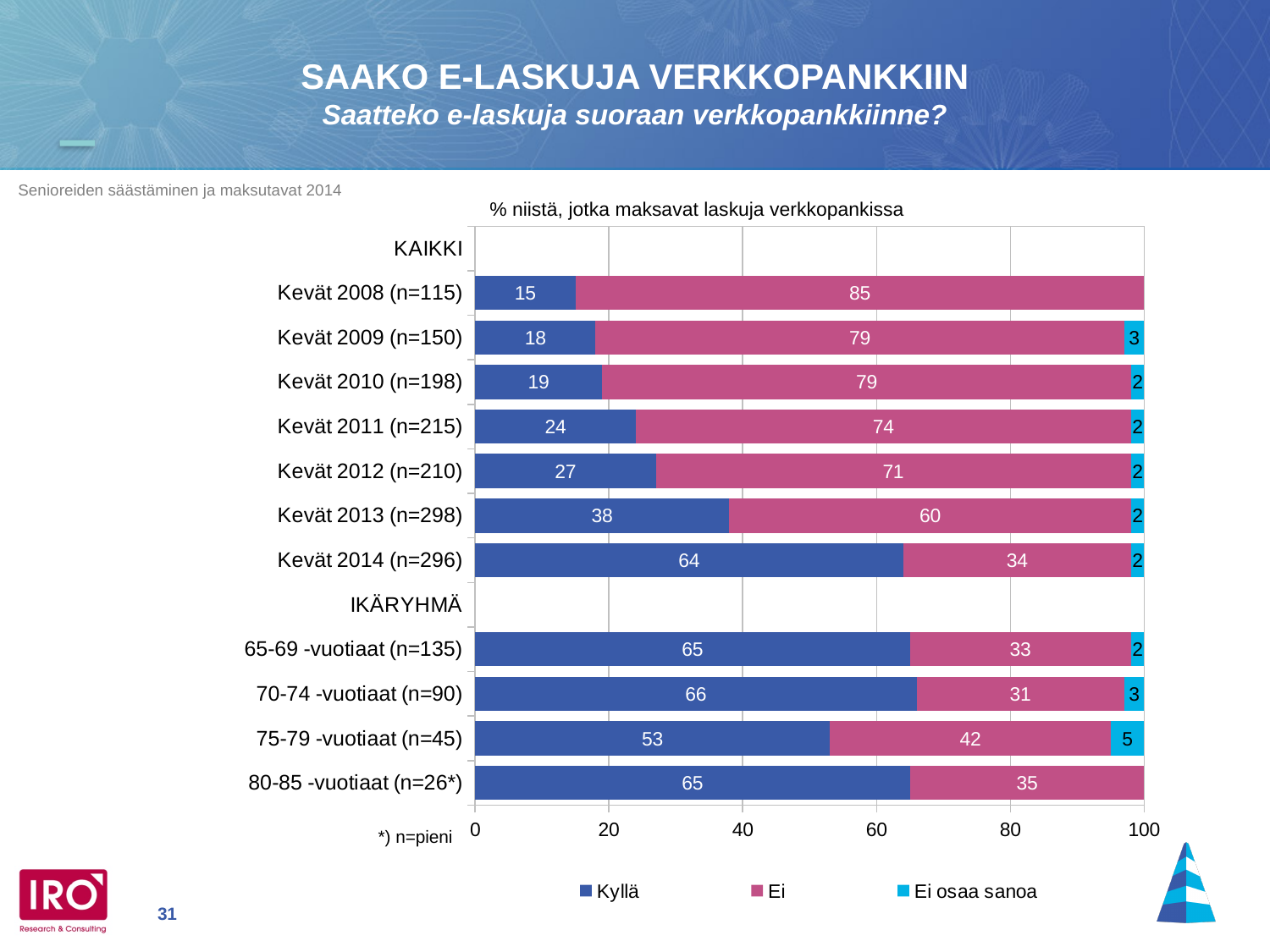
What is the total of the stacked bar for 80-85 -vuotiaat (n=26*)? 100 Among the Kevät rows, which year has the highest Kyllä value? Kevät 2014 (n=296) What is the Ei osaa sanoa value for 75-79 -vuotiaat (n=45)? 5 What is the Kyllä value for Kevät 2008 (n=115)? 15 Which is larger, the Ei value for Kevät 2011 (n=215) or the Ei value for Kevät 2012 (n=210)? Kevät 2011 (n=215) What is the Kyllä value for 70-74 -vuotiaat (n=90)? 66 Among the age groups, which has the lowest Kyllä value? 75-79 -vuotiaat (n=45) What is the Ei value for Kevät 2013 (n=298)? 60 What is the difference between the Kyllä values for Kevät 2014 (n=296) and Kevät 2013 (n=298)? 26 How many series does the legend list? 3 Do the Kyllä values rise or fall from Kevät 2008 to Kevät 2014? Rise What kind of chart is shown on the slide? Stacked bar chart